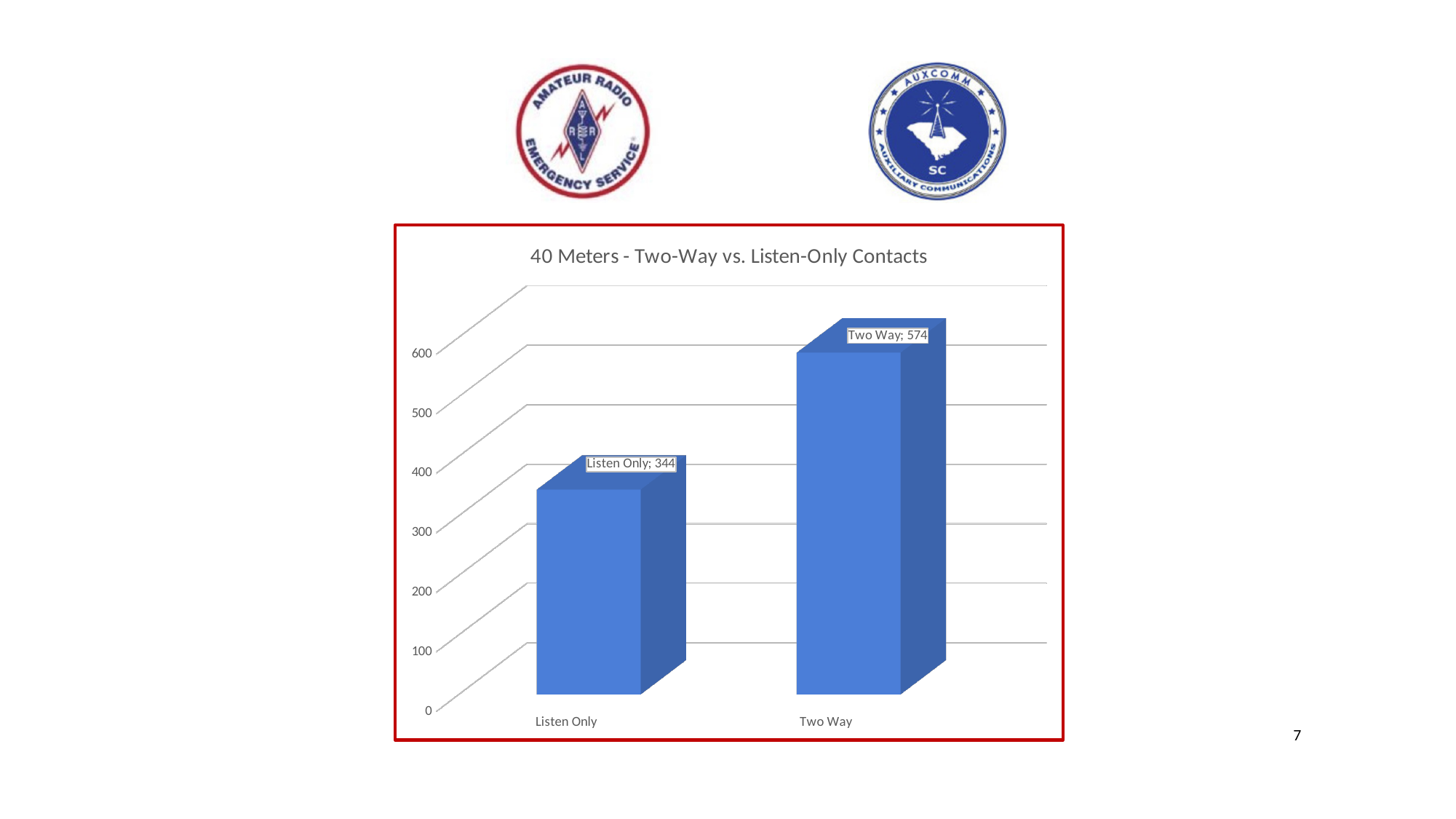
What is the value for Listen Only? 344 Which category has the highest value? Two Way Is the value for Two Way greater or less than 500? greater What is the total of the Listen Only and Two Way values combined? 918 What kind of chart is shown on the slide? bar chart What is the value for Two Way? 574 What is the title of the chart? 40 Meters - Two-Way vs. Listen-Only Contacts What is the difference between the Two Way and Listen Only values? 230 Which category has the lowest value? Listen Only How many categories are shown on the x axis? 2 Which is larger, the value for Listen Only or the value for Two Way? Two Way Is the value for Listen Only greater or less than 400? less